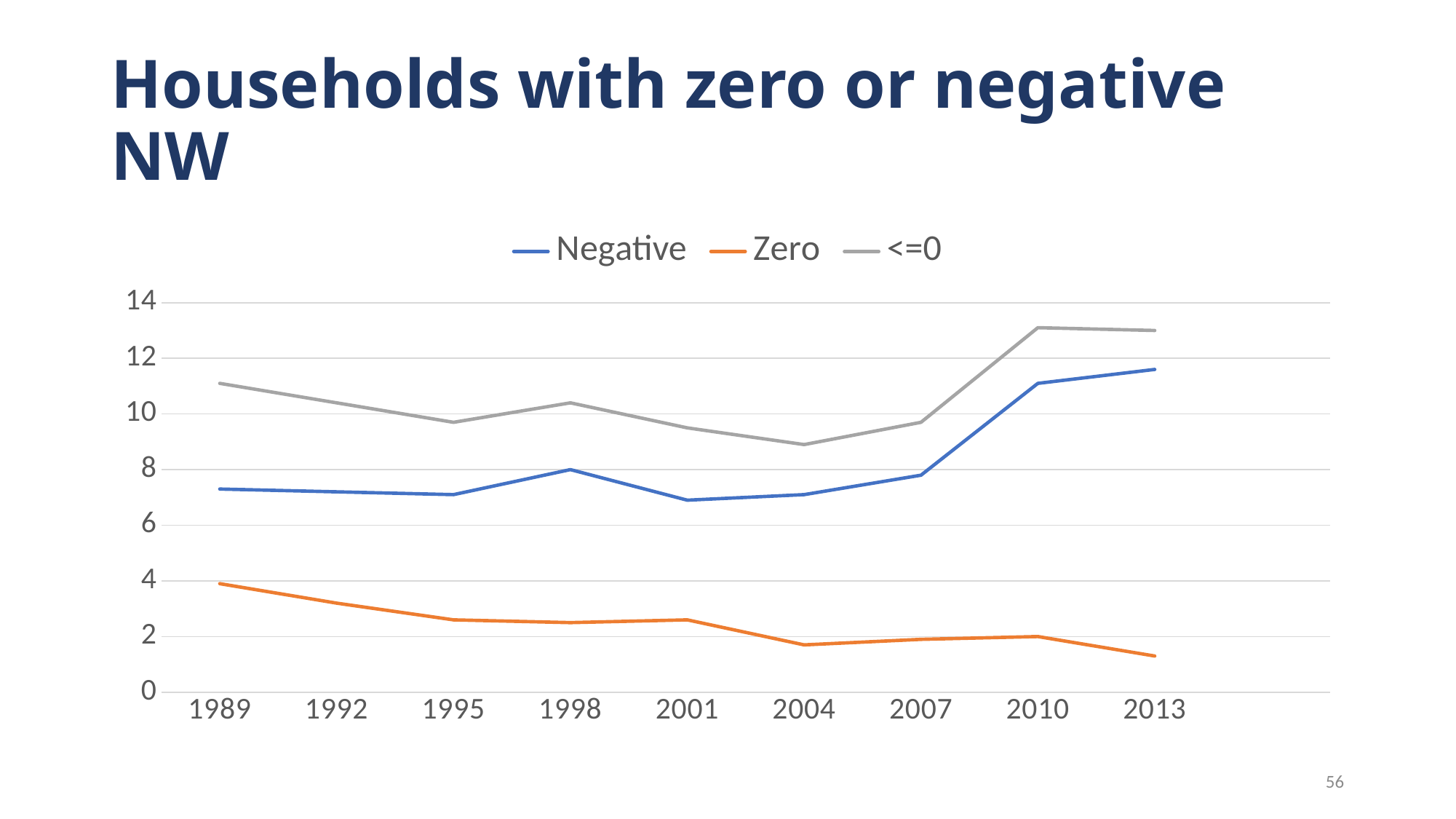
Does the Zero series generally rise or fall from 1989 to 2013? fall Which series has the larger value in 2013, Negative or Zero? Negative Is the value for the Zero series in 2004 greater or less than 2? less How many series does the legend list? 3 How many years are plotted along the x axis? 9 Is the value for the <=0 series in 2004 greater or less than 10? less Is the value for the Negative series in 2010 greater or less than 10? greater In which year does the Zero series reach its highest value? 1989 What kind of chart is shown on the slide? line chart In which year does the Negative series reach its highest value? 2013 In which year does the Zero series reach its lowest value? 2013 In which year does the <=0 series reach its lowest value? 2004